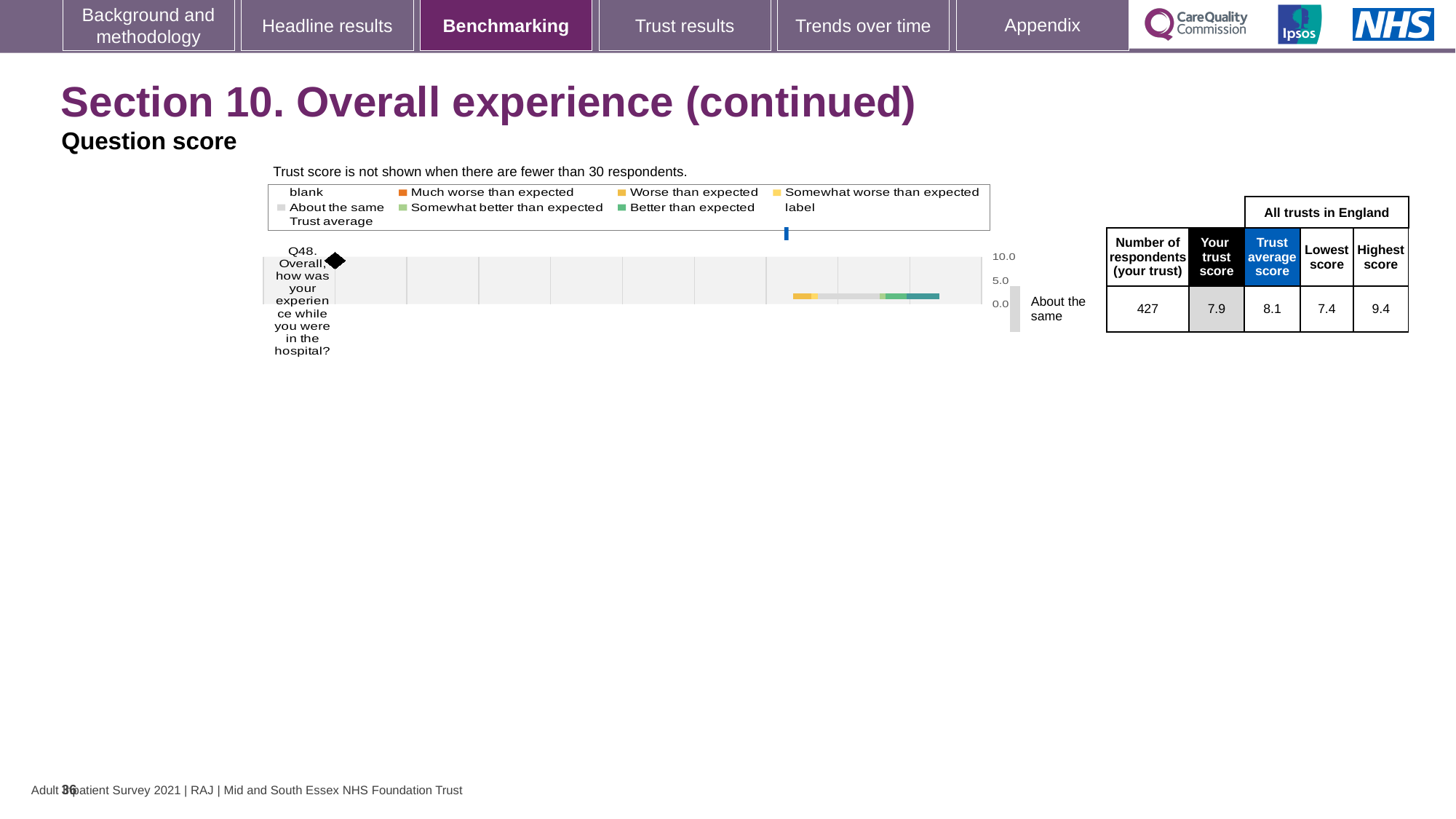
How many questions are plotted on the benchmarking chart? 1 What is the difference between the trust average score and the trust score for Q48? 0.2 What is the trust score for Q48 shown in the table next to the chart? 7.9 Which legend entry is shown with an orange marker? Much worse than expected How is the trust's result for Q48 categorised relative to expectations, according to the label beside the chart? About the same What is the trust average score for Q48 across all trusts in England? 8.1 What is the lowest score among all trusts in England for Q48? 7.4 How many respondents from the trust answered Q48? 427 What is the difference between the highest score and the lowest score for Q48 across all trusts in England? 2.0 What kind of chart is used to show the Q48 benchmarking result? Bar chart What is the highest score among all trusts in England for Q48? 9.4 Which is larger for Q48: the trust score or the trust average score? Trust average score